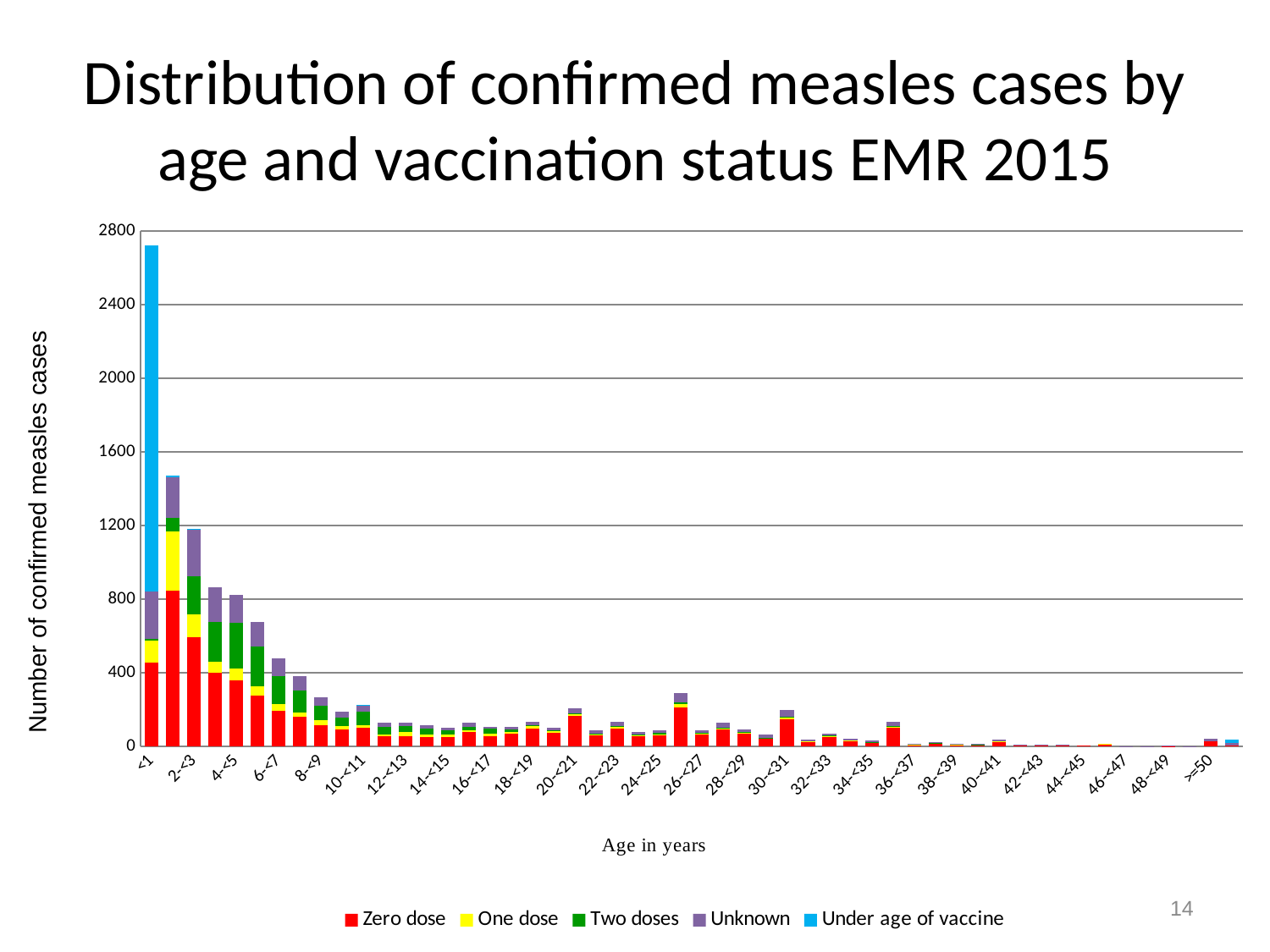
Do the total numbers of confirmed measles cases generally rise or fall as age increases along the x axis? fall Is the total number of cases for the 8-<9 age group greater or less than 400? less Which age group has the highest total number of confirmed measles cases? <1 How many series does the legend list? 5 Is the total number of cases for the <1 age group greater or less than 2400? greater Which series is shown in blue in the legend? Under age of vaccine What kind of chart is shown on the slide? Stacked bar chart Which age group has more confirmed measles cases, <1 or 2-<3? <1 Is the total number of cases for the 2-<3 age group greater or less than 800? greater Which age group has more confirmed measles cases, 6-<7 or 8-<9? 6-<7